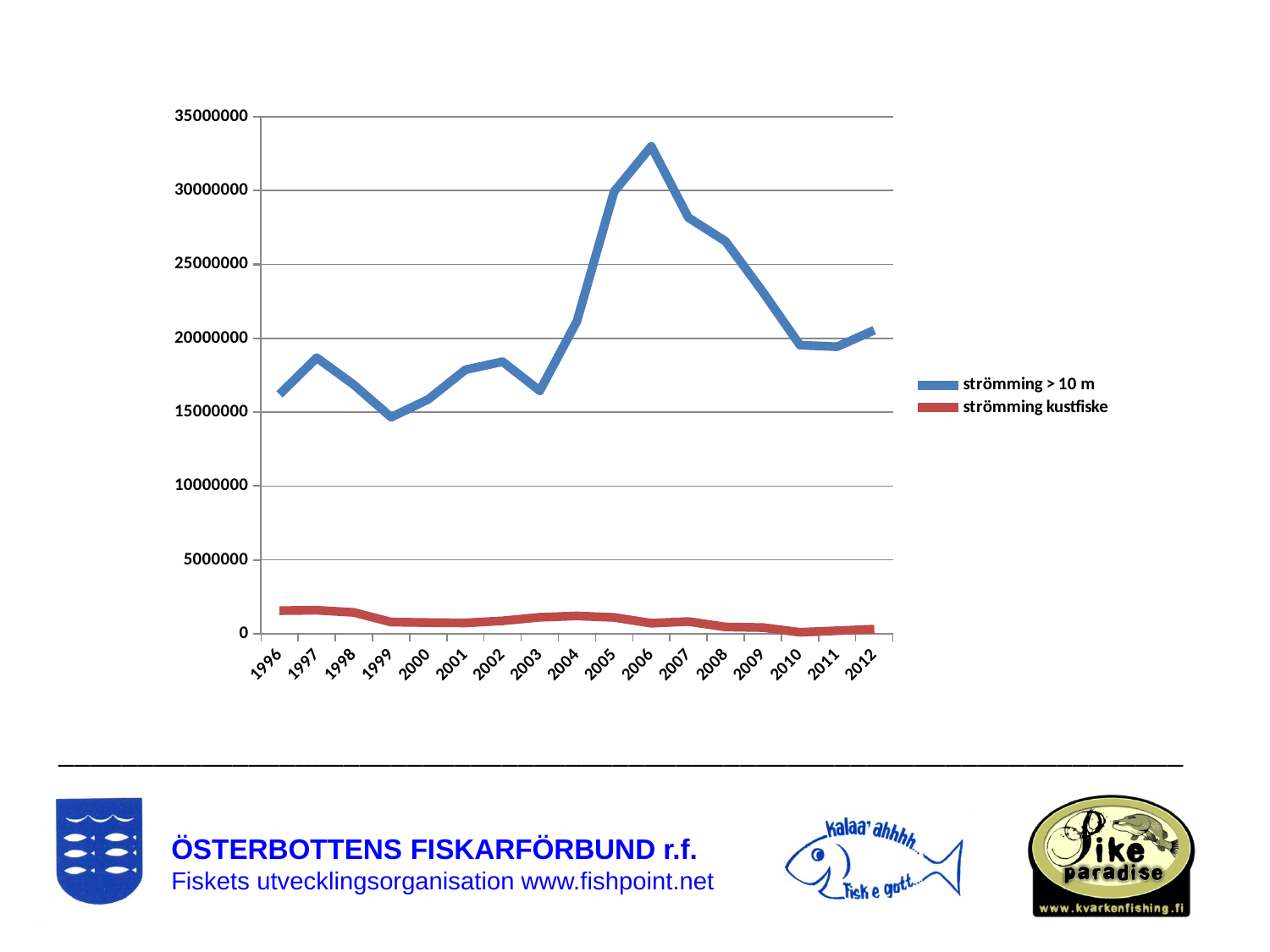
How many years are plotted along the x axis? 17 How many series does the legend list? 2 Is the value for 'strömming > 10 m' in 2009 greater or less than 25000000? less Is the value for 'strömming > 10 m' in 2006 greater or less than 30000000? greater Which colour represents 'strömming kustfiske' in the legend? red Is the value for 'strömming kustfiske' in 2004 greater or less than 5000000? less What kind of chart is shown on the slide? line chart Does the 'strömming > 10 m' series rise or fall from 2006 to 2010? fall In which year does the 'strömming > 10 m' series reach its highest value? 2006 Which is larger for 'strömming > 10 m': the value in 2006 or the value in 2010? 2006 In which year does the 'strömming > 10 m' series reach its lowest value? 1999